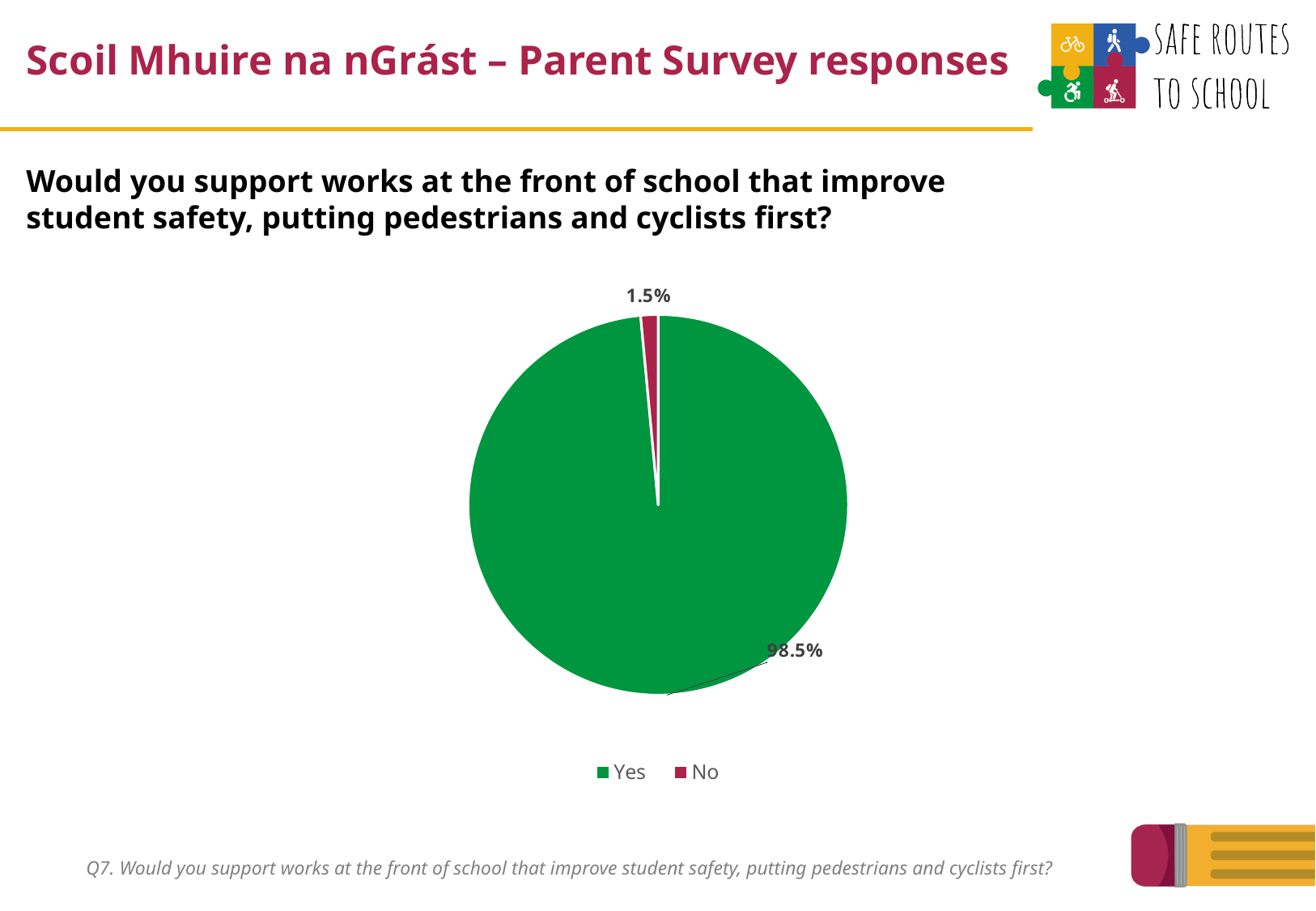
What share of the pie does the Yes slice represent? 98.5% Which is larger, the Yes slice or the No slice? Yes How many categories does the pie chart show? 2 Which category has the largest slice of the pie? Yes What kind of chart is shown on the slide? pie chart How many entries does the legend list? 2 What colour is the No slice of the pie? red Which category has the smallest slice of the pie? No What colour is the Yes slice of the pie? green What share of the pie does the No slice represent? 1.5% What is the difference in percentage points between the Yes and No slices? 97 percentage points